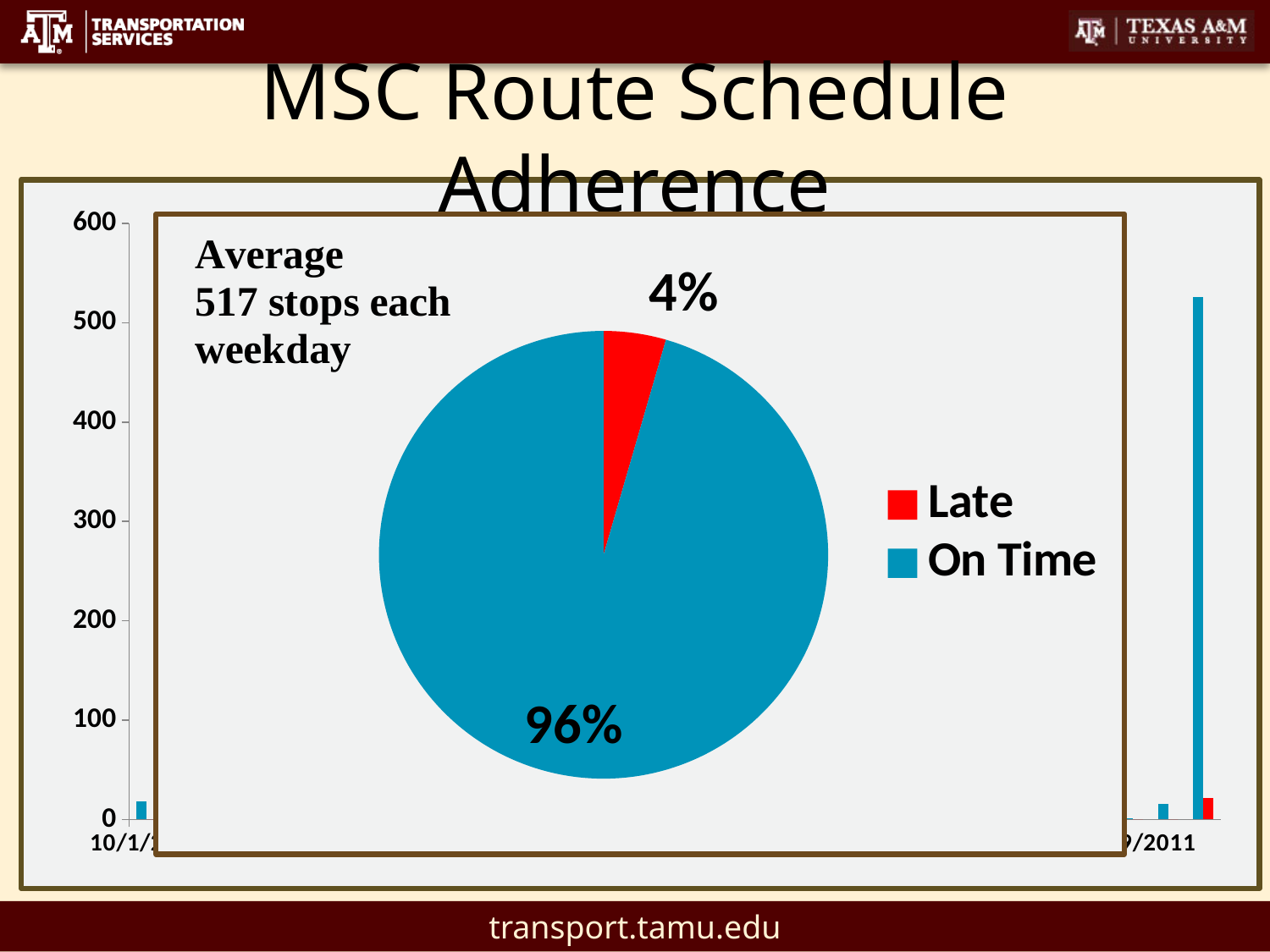
In the pie chart, which category has the smallest slice? Late How many entries does the pie chart's legend list? 2 In the pie chart, which category has the largest slice? On Time What kind of chart is the chart in the background behind the pie chart? Bar chart In the pie chart, what share of stops is labelled On Time? 96% What kind of chart is the chart in the foreground showing Late and On Time? Pie chart In the pie chart, what colour is the Late slice? Red In the background bar chart, is the tallest bar greater or less than 500? greater In the pie chart, which slice is larger, Late or On Time? On Time According to the text on the pie chart, what is the average number of stops each weekday? 517 In the pie chart, what share of stops is labelled Late? 4% In the pie chart, what is the difference in percentage points between the On Time and Late slices? 92